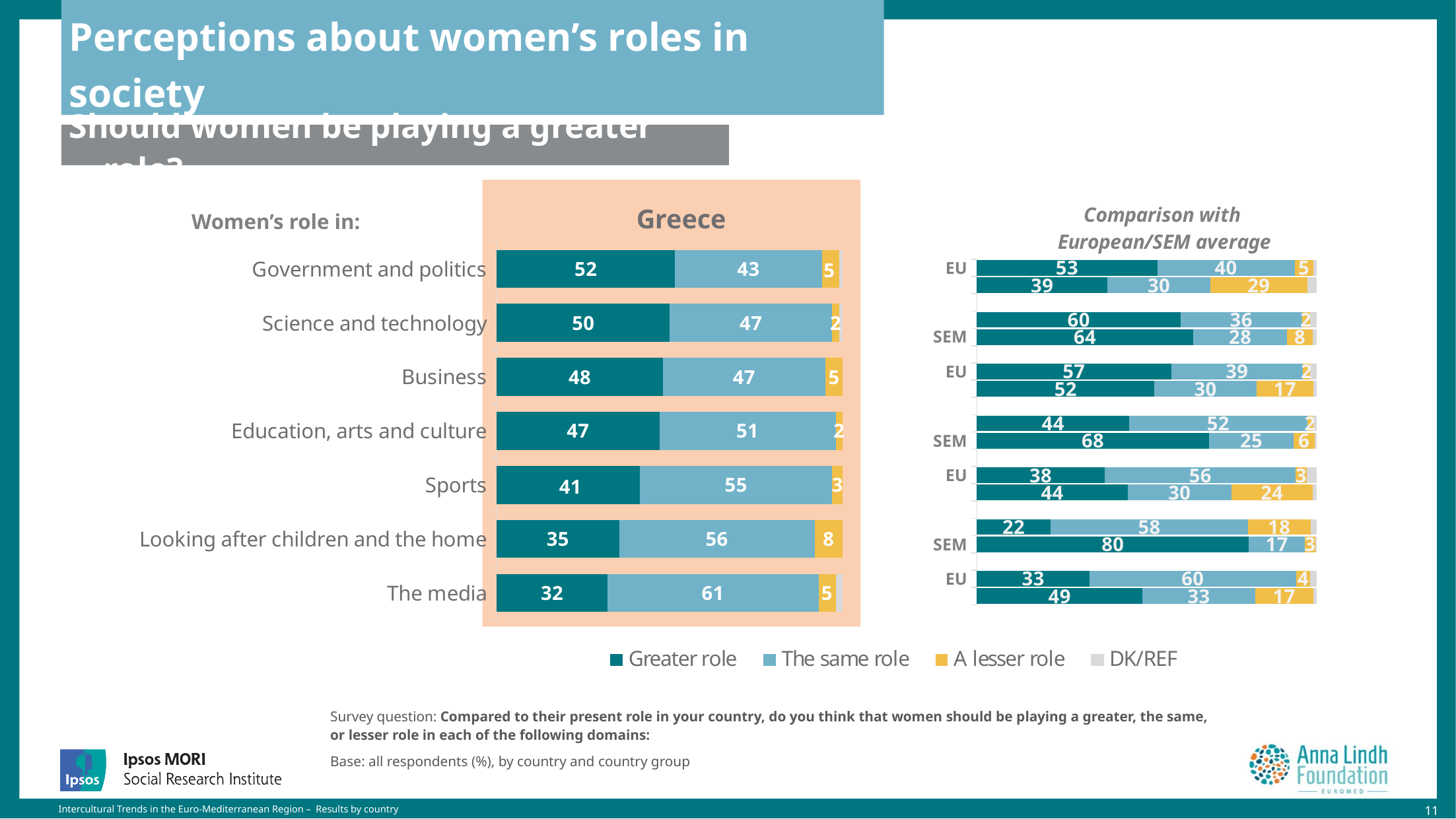
In the Greece chart, is the 'The same role' value larger for Sports or for Business? Sports What type of chart is used to show the Greece results? Stacked bar chart How many series does the legend list? 4 In the Greece chart, which domain has the highest 'Greater role' value? Government and politics In the Greece chart, what percentage say women should play a greater role in Government and politics? 52 Which colour represents 'A lesser role' in the legend? Yellow In the Greece chart, what is the difference between the 'Greater role' values for Government and politics and The media? 20 How many domains are listed in the Greece chart? 7 In the Greece chart, what is the 'The same role' value for The media? 61 In the Greece chart, what is the total of the 'Greater role' and 'The same role' values for Science and technology? 97 In the Greece chart, which domain has the lowest 'Greater role' value? The media In the Greece chart, what is the 'A lesser role' value for Looking after children and the home? 8